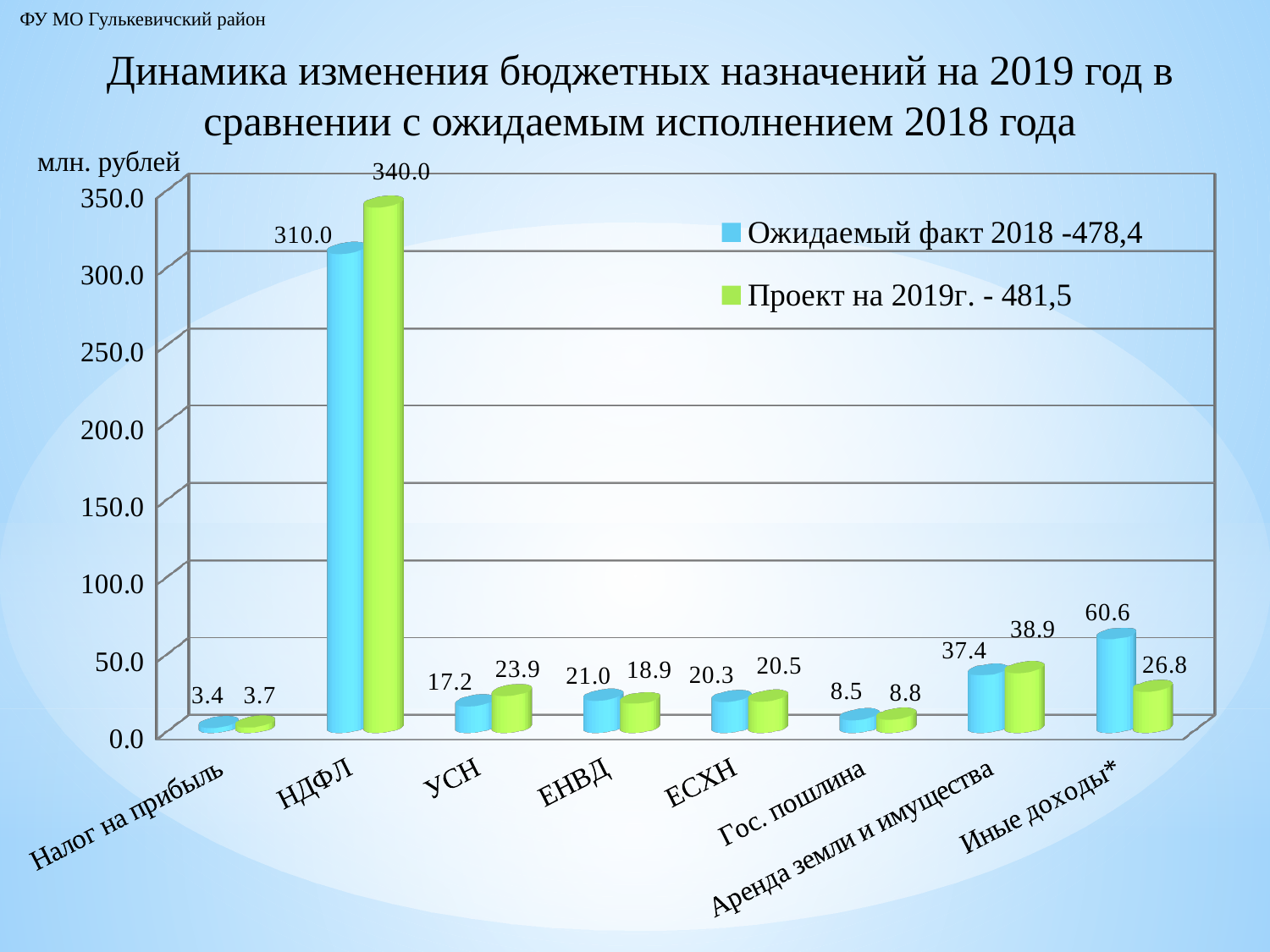
What is the value for Аренда земли и имущества in the Ожидаемый факт 2018 series? 37.4 For УСН, which series has the larger value: Ожидаемый факт 2018 or Проект на 2019г.? Проект на 2019г. What is the difference between the Ожидаемый факт 2018 and Проект на 2019г. values for Иные доходы*? 33.8 What is the difference between the Проект на 2019г. and Ожидаемый факт 2018 values for НДФЛ? 30.0 What is the value for НДФЛ in the Проект на 2019г. series? 340.0 Which category has the highest value in the Проект на 2019г. series? НДФЛ Which category has the lowest value in the Ожидаемый факт 2018 series? Налог на прибыль How many series does the legend list? 2 What is the value for Иные доходы* in the Проект на 2019г. series? 26.8 What is the value for НДФЛ in the Ожидаемый факт 2018 series? 310.0 What kind of chart is shown on the slide? Bar chart How many categories are shown on the x axis? 8